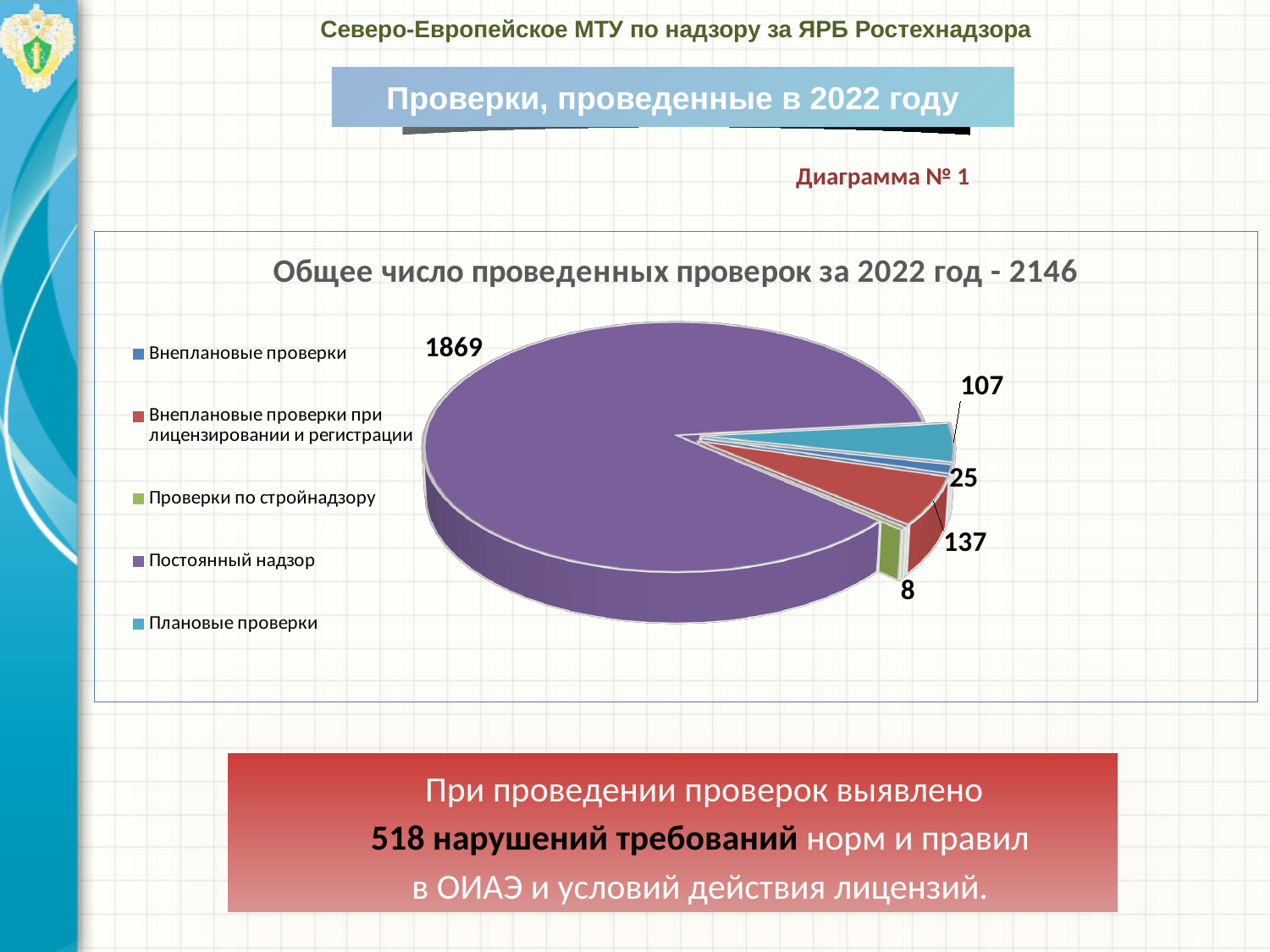
What is the value for Внеплановые проверки? 25 What is the difference between the values for Внеплановые проверки при лицензировании и регистрации and Плановые проверки? 30 Which is larger: Плановые проверки or Внеплановые проверки? Плановые проверки What is the value for Постоянный надзор in the pie chart? 1869 What is the value for Внеплановые проверки при лицензировании и регистрации? 137 What is the value for Плановые проверки in the pie chart? 107 How many categories does the legend of the pie chart list? 5 What is the value for Проверки по стройнадзору? 8 What is the title of the pie chart? Общее число проведенных проверок за 2022 год - 2146 Which category has the largest slice of the pie? Постоянный надзор What kind of chart is shown on the slide? pie chart Which category has the smallest slice of the pie? Проверки по стройнадзору